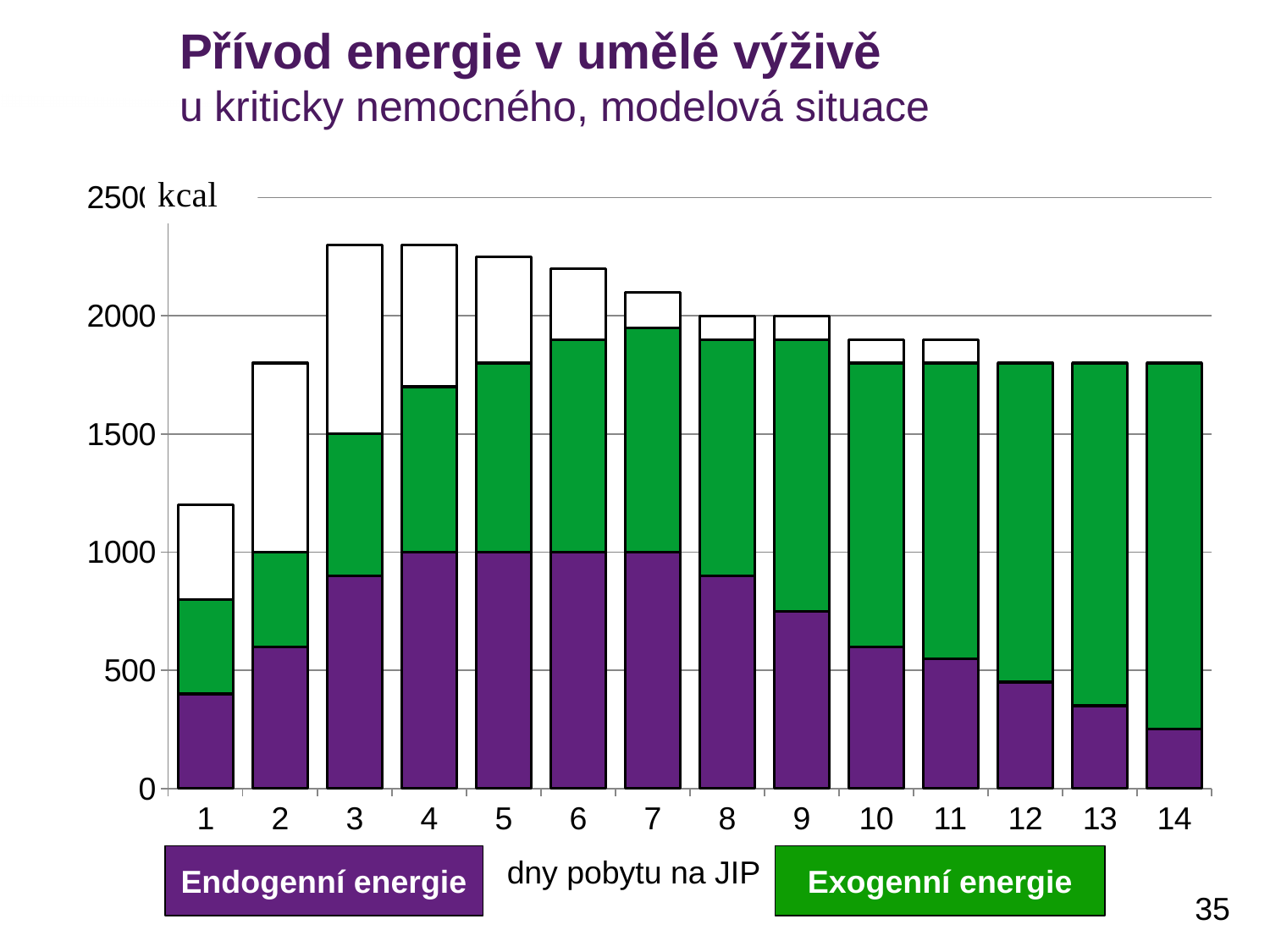
Is the Exogenní energie value for day 14 greater or less than 1000? greater Is the total height of the bar for day 1 greater or less than 1500? less What kind of chart is shown on the slide? bar chart How many days (categories) are plotted on the x axis? 14 Is the total height of the bar for day 3 greater or less than 2000? greater Does the Endogenní energie value rise or fall from day 7 to day 14? fall What is the label of the x axis? dny pobytu na JIP Which is larger, the Endogenní energie value for day 2 or for day 13? day 2 Which series is shown in purple according to the legend? Endogenní energie Which day has the lowest total bar? 1